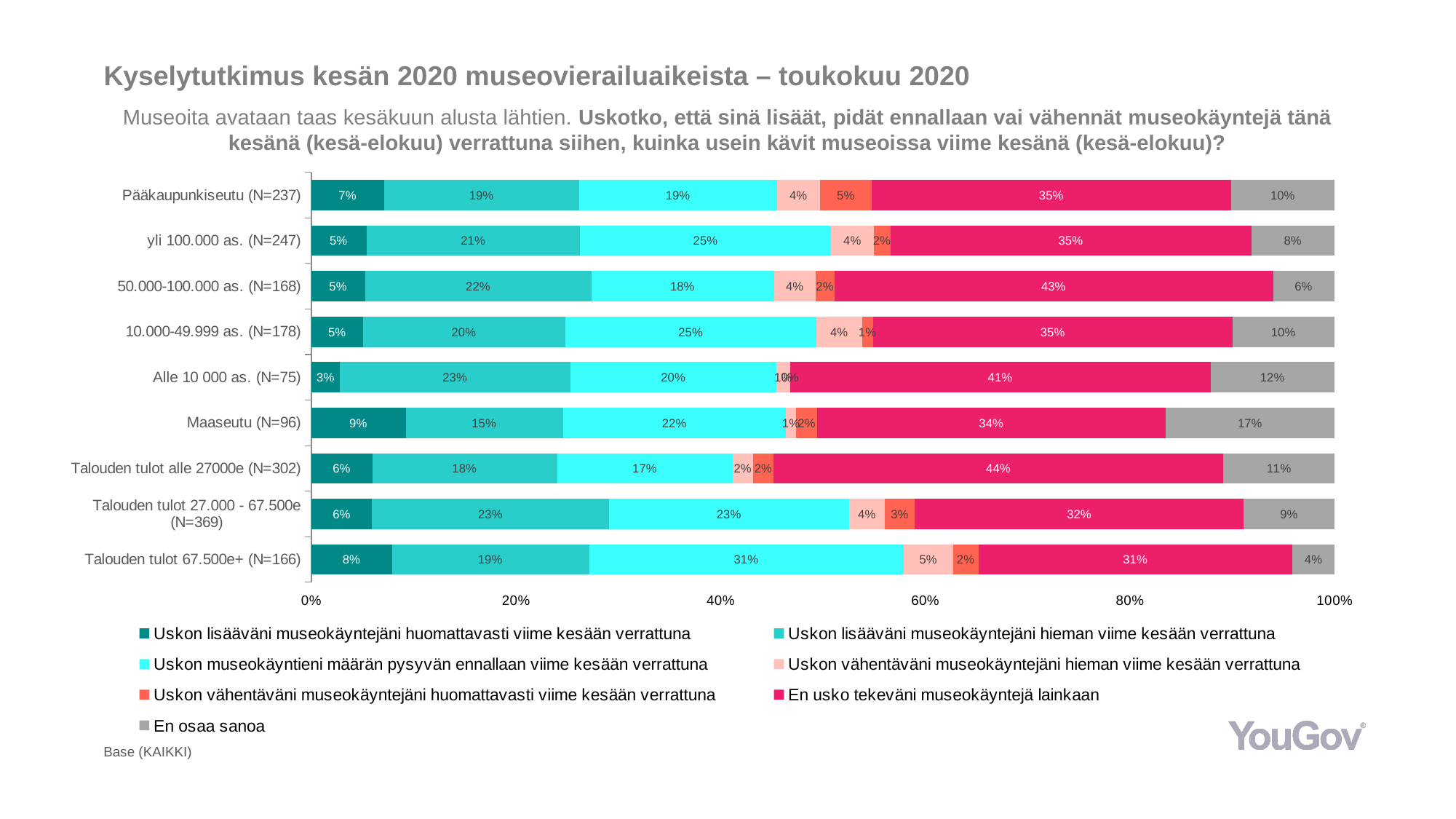
How many response categories does the legend list? 7 Which group has the highest share for "En usko tekeväni museokäyntejä lainkaan"? Talouden tulot alle 27000e (N=302) How many percentage points higher is the "Uskon lisääväni museokäyntejäni huomattavasti" share for Maaseutu (N=96) than for Pääkaupunkiseutu (N=237)? 2 percentage points What type of chart is shown on the slide? Stacked bar chart Which has the larger "Uskon lisääväni museokäyntejäni hieman viime kesään verrattuna" share: Maaseutu (N=96) or Talouden tulot 27.000 - 67.500e (N=369)? Talouden tulot 27.000 - 67.500e (N=369) What percentage of the 50.000-100.000 as. (N=168) group answered "En usko tekeväni museokäyntejä lainkaan"? 43% Which group has the lowest "En osaa sanoa" share? Talouden tulot 67.500e+ (N=166) How many respondent groups are shown on the chart? 9 What is the value for "Uskon museokäyntieni määrän pysyvän ennallaan viime kesään verrattuna" in the Talouden tulot 67.500e+ (N=166) group? 31% What is the "En osaa sanoa" value for Maaseutu (N=96)? 17% What percentage of Pääkaupunkiseutu (N=237) respondents answered "Uskon vähentäväni museokäyntejäni huomattavasti viime kesään verrattuna"? 5% Which group has the highest "En osaa sanoa" share? Maaseutu (N=96)